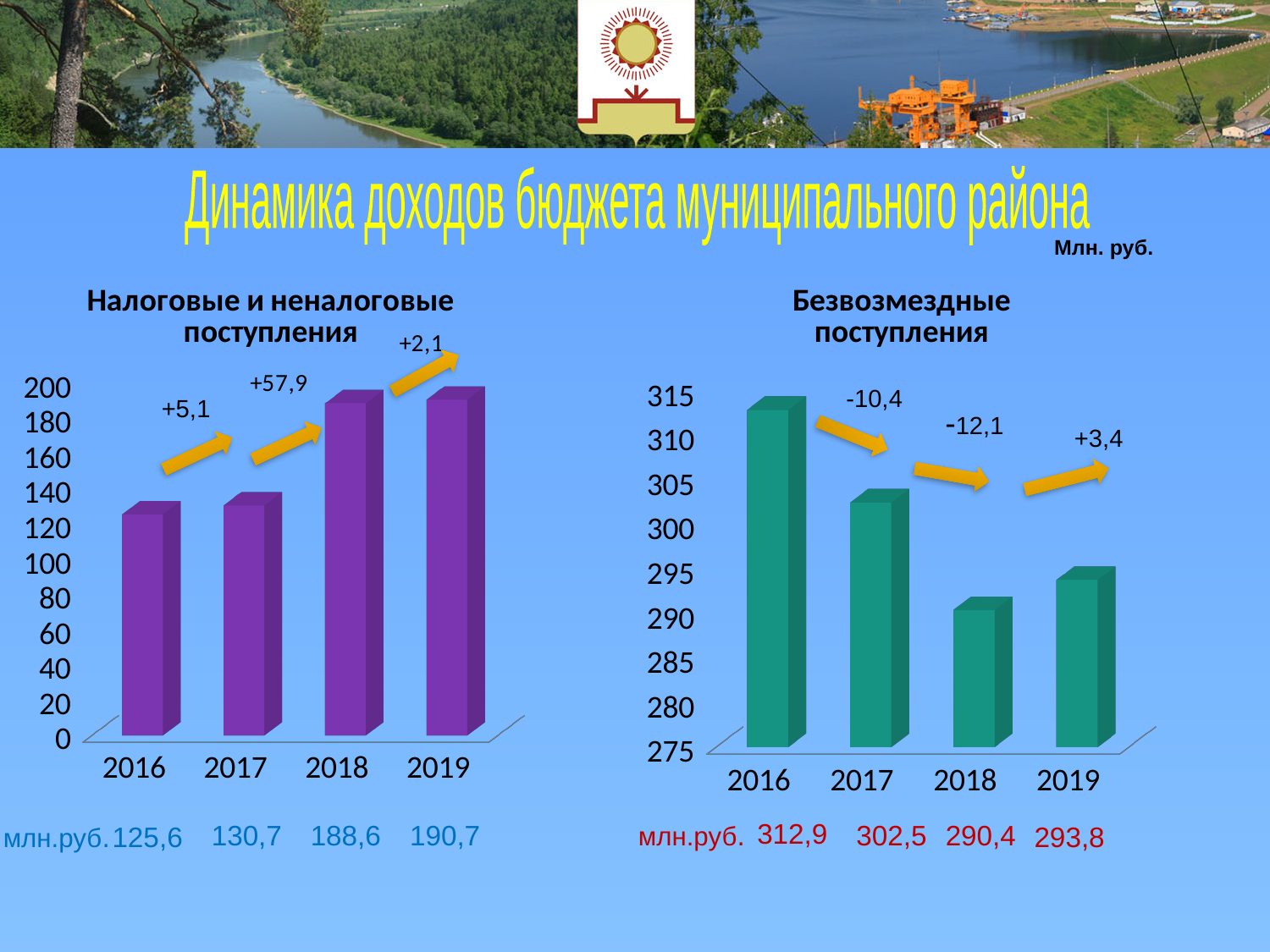
On the chart titled 'Налоговые и неналоговые поступления', which is larger: the value for 2016 or the value for 2018? 2018 On the chart titled 'Безвозмездные поступления', which year has the lowest value? 2018 On the chart titled 'Налоговые и неналоговые поступления', which year has the highest value? 2019 What kind of chart is the chart titled 'Безвозмездные поступления'? bar chart On the chart titled 'Безвозмездные поступления', what is the difference between the 2016 and 2017 values? 10,4 On the chart titled 'Безвозмездные поступления', which year has the highest value? 2016 On the chart titled 'Безвозмездные поступления', is the value for 2018 greater or less than 295? less How many years are shown on the chart titled 'Налоговые и неналоговые поступления'? 4 On the chart titled 'Налоговые и неналоговые поступления', what is the difference between the 2018 and 2017 values? 57,9 On the chart titled 'Налоговые и неналоговые поступления', what is the value for 2018? 188,6 On the chart titled 'Безвозмездные поступления', what is the value for 2017? 302,5 On the chart titled 'Налоговые и неналоговые поступления', do the values rise or fall from 2016 to 2019? rise